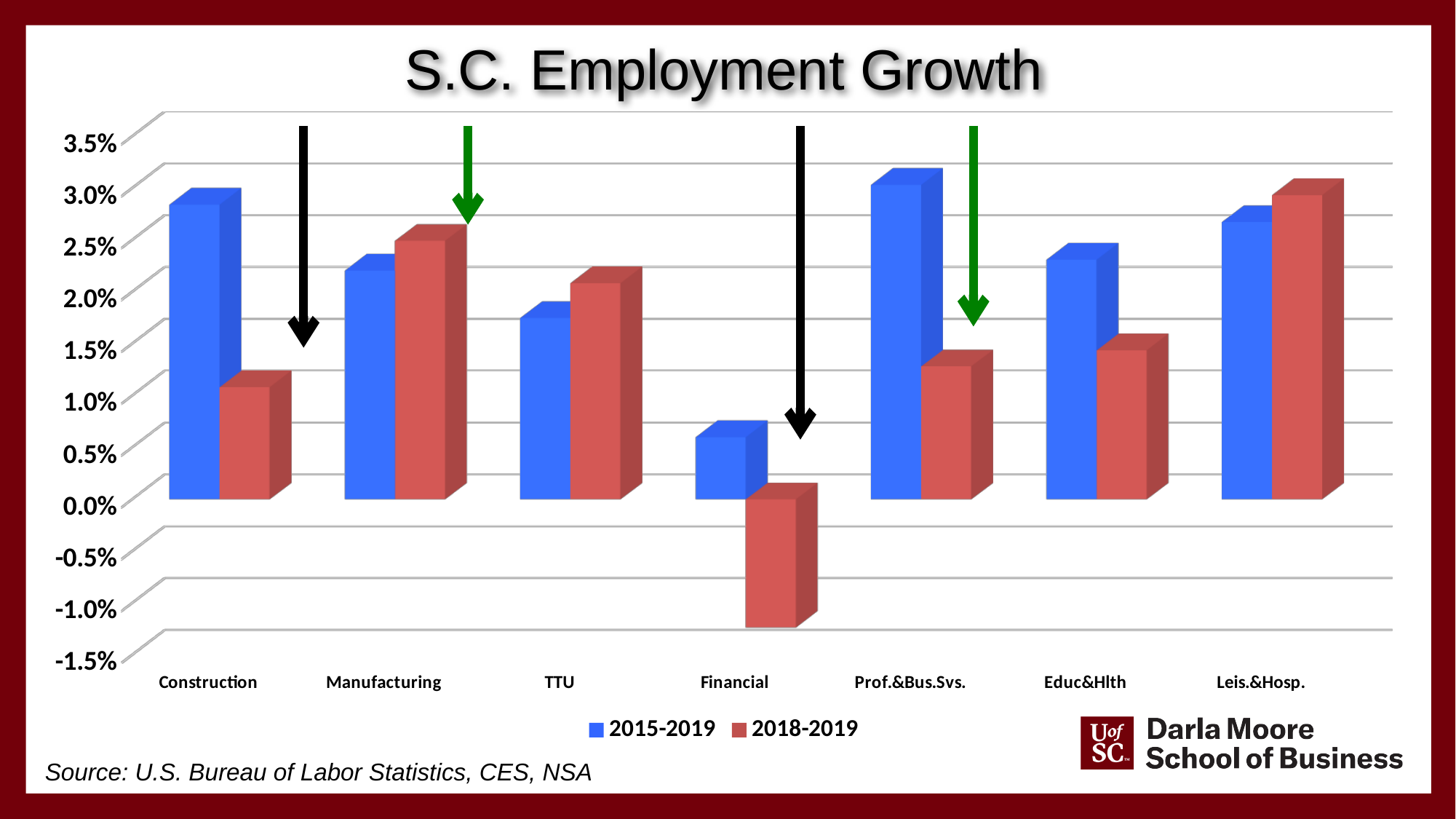
Is the 2018-2019 value for Prof.&Bus.Svs. greater or less than 2.0%? less How many series does the legend list? 2 Which category has the highest 2018-2019 value? Leis.&Hosp. For Construction, which series has the larger value, 2015-2019 or 2018-2019? 2015-2019 Which category has the lowest 2018-2019 value? Financial Which category has the lowest 2015-2019 value? Financial What is the title of the chart? S.C. Employment Growth How many industry categories are shown on the x axis? 7 Is the 2015-2019 value for Construction greater or less than 2.5%? greater What kind of chart is shown on the slide? Bar chart Which category has the highest 2015-2019 value? Prof.&Bus.Svs. Is the 2018-2019 value for Financial greater or less than 0.0%? less